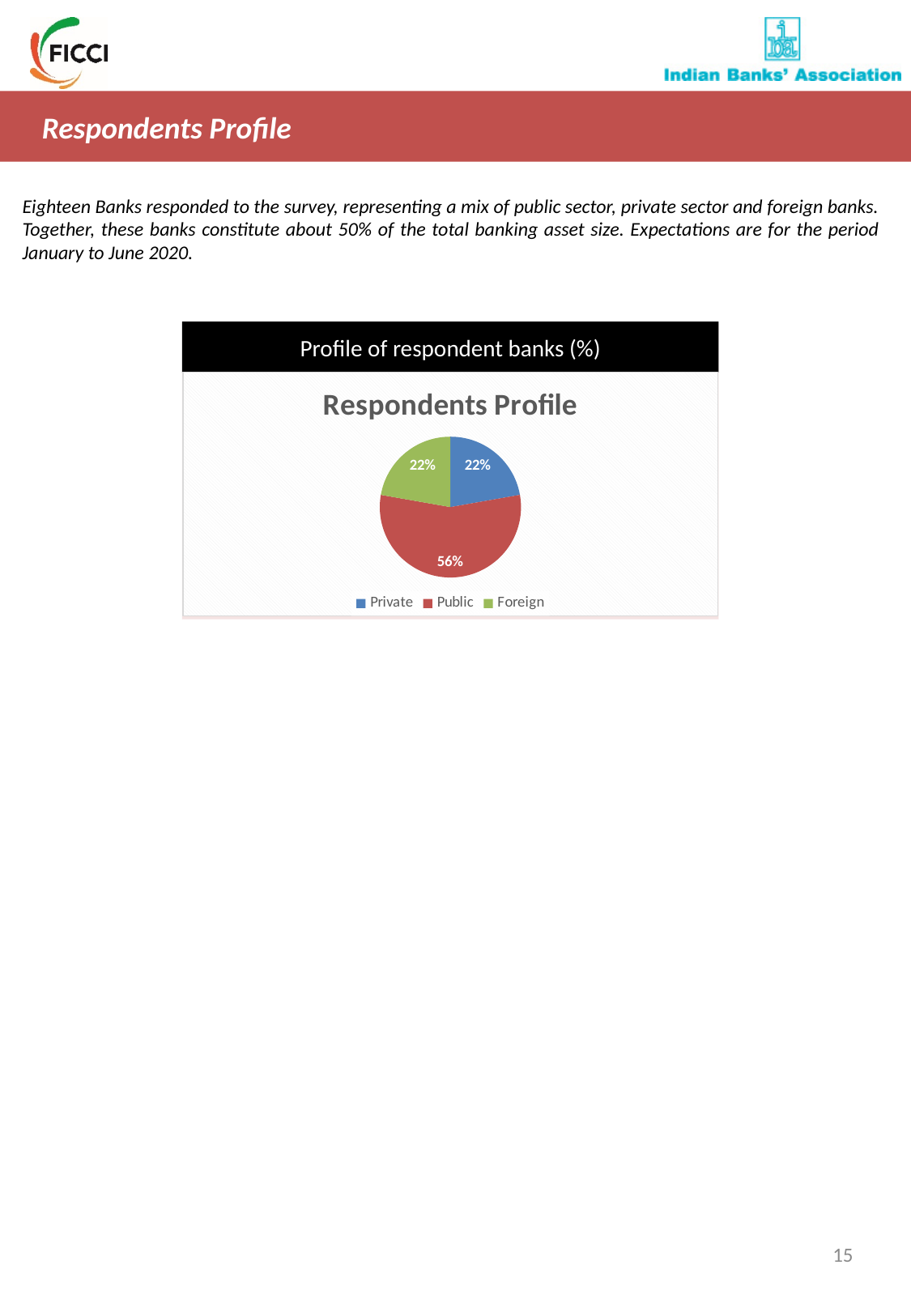
What share of respondent banks are Private? 22% Which colour represents Public in the pie chart? red What kind of chart is shown on the slide? pie chart What is the difference between the Public share and the Private share? 34% How many categories are shown in the pie chart? 3 Which category has the largest share of the pie? Public What is the title shown inside the chart area? Respondents Profile What is the combined share of Private and Foreign banks? 44% What share of respondent banks are Foreign? 22% Is the share for Public larger or smaller than the share for Foreign? larger What share of respondent banks are Public? 56%